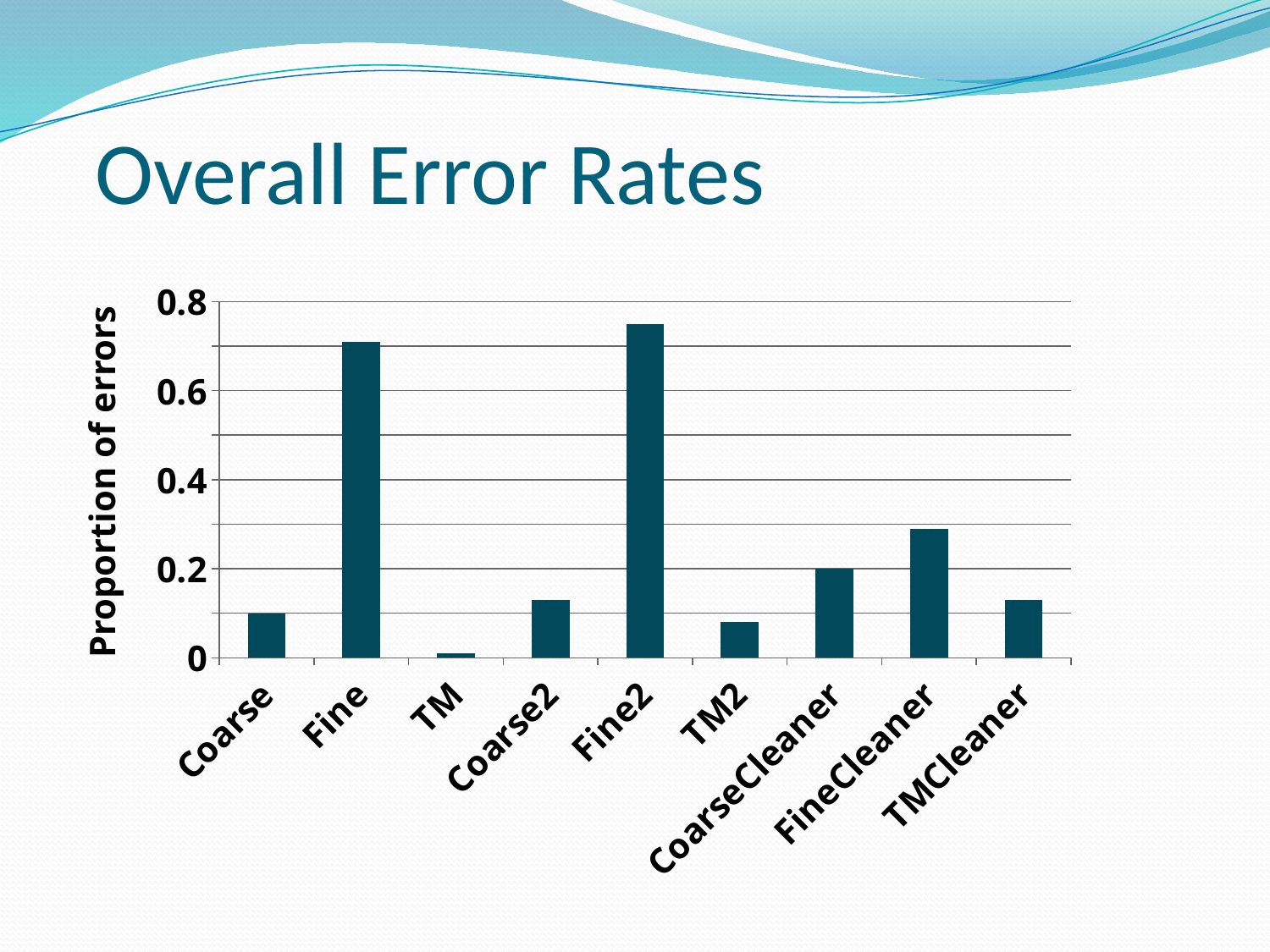
What is the label on the vertical axis of the chart? Proportion of errors Which category has the highest proportion of errors? Fine2 How many categories are shown on the x axis of the chart? 9 What kind of chart is shown on the slide? bar chart Is the value for TM2 greater or less than 0.2? less Is the value for Coarse greater or less than 0.4? less Which has a higher proportion of errors, CoarseCleaner or FineCleaner? FineCleaner Which category has the lowest proportion of errors? TM What is the title of the slide containing the chart? Overall Error Rates Which has a higher proportion of errors, Fine or Fine2? Fine2 Is the value for FineCleaner greater or less than 0.2? greater